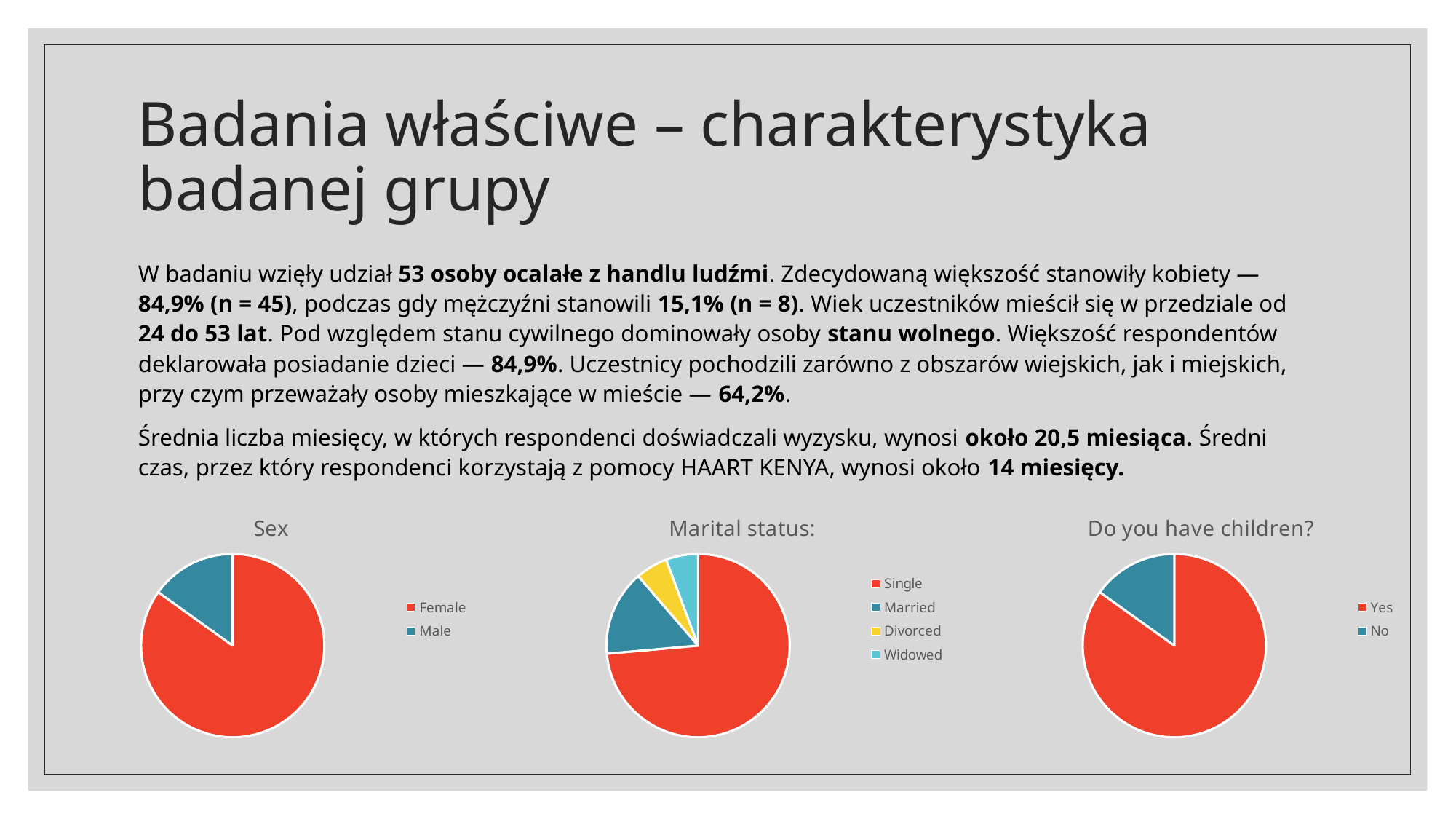
How many categories does the legend of the "Marital status:" chart list? 4 In the "Marital status:" chart, which slice is larger, Married or Divorced? Married In the "Marital status:" chart, which colour represents Divorced? yellow How many categories does the legend of the "Sex" chart list? 2 What kind of chart is the "Do you have children?" chart? pie chart How many pie charts are shown on the slide? 3 In the "Sex" chart, which category has the smallest slice? Male In the "Do you have children?" chart, which slice is smaller, Yes or No? No What kind of chart is the "Sex" chart? pie chart In the "Sex" chart, which category has the largest slice? Female In the "Marital status:" chart, which category has the largest slice? Single In the "Do you have children?" chart, which category has the largest slice? Yes